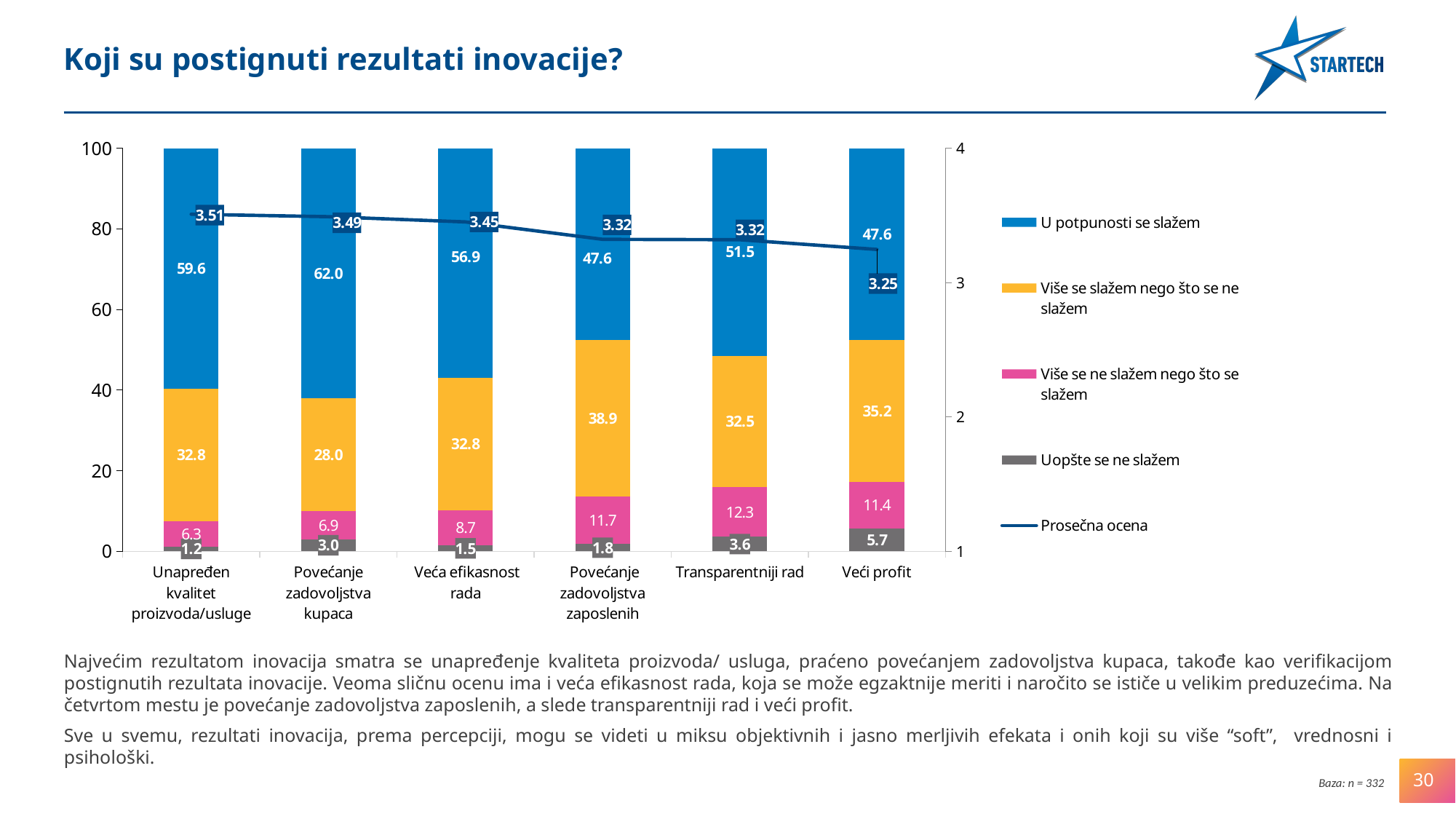
What is the Prosečna ocena for Veći profit? 3.25 Which category has the highest Prosečna ocena? Unapređen kvalitet proizvoda/usluge How many series does the legend list? 5 What is the difference between the "Više se slažem nego što se ne slažem" values for Povećanje zadovoljstva zaposlenih and Povećanje zadovoljstva kupaca? 10.9 How many categories are shown on the x axis? 6 Which category has the lowest value for "U potpunosti se slažem"? Povećanje zadovoljstva zaposlenih and Veći profit (47.6) What is the value of "Uopšte se ne slažem" for Transparentniji rad? 3.6 What is the value of "Uopšte se ne slažem" for Veći profit? 5.7 What kind of chart is shown on the slide? Stacked bar chart with a line What is the value of "U potpunosti se slažem" for Povećanje zadovoljstva kupaca? 62.0 Does the Prosečna ocena line rise or fall from left to right across the categories? Fall